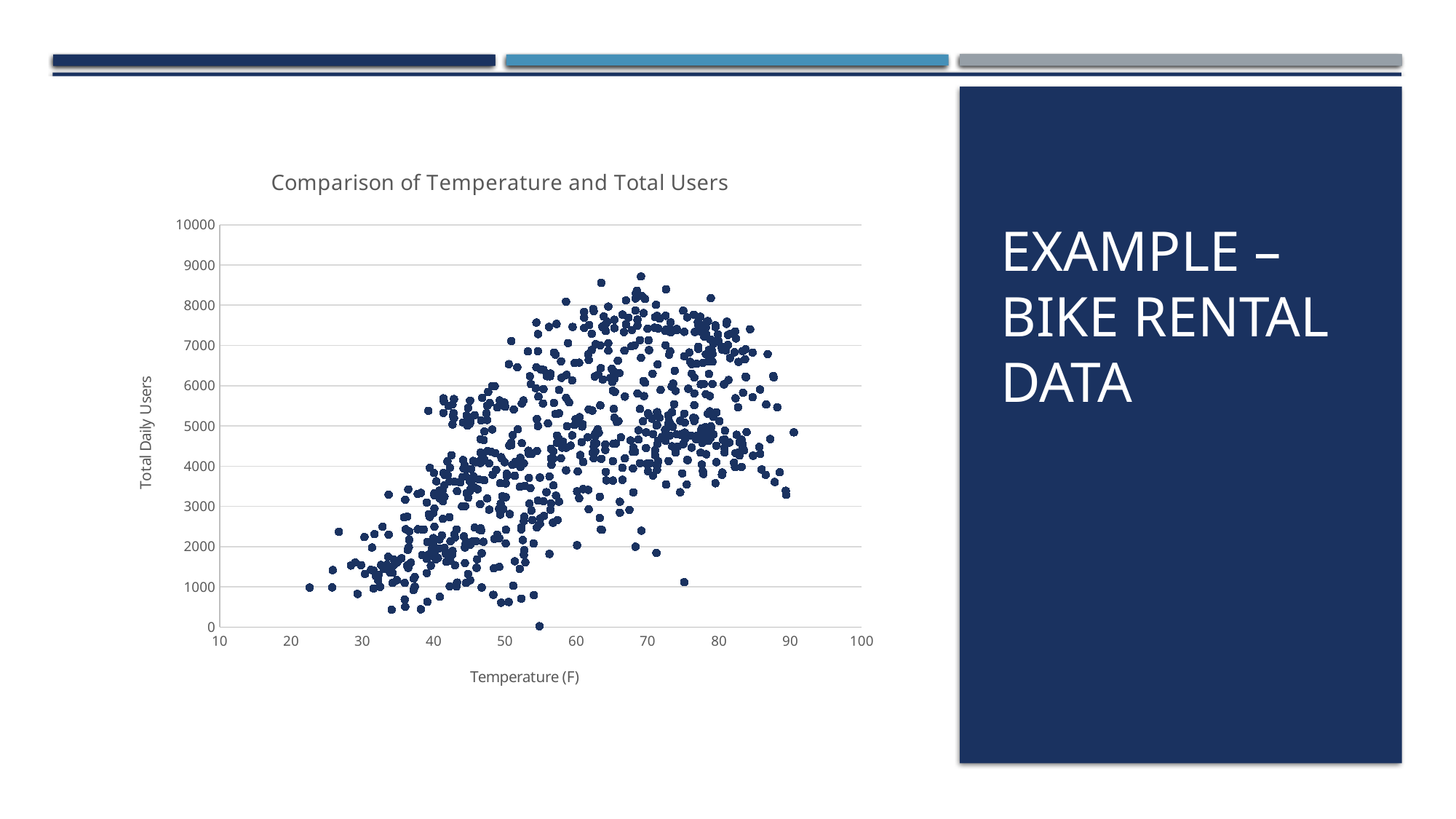
Is the lowest Temperature (F) value plotted greater or less than 20? greater Do the Total Daily Users values generally rise or fall as Temperature (F) increases along the x axis? Rise What is the title of the chart? Comparison of Temperature and Total Users Is the highest Total Daily Users value plotted greater or less than 9000? less Is the lowest Total Daily Users value plotted greater or less than 1000? less What kind of chart is shown on the slide? Scatter plot What are the labels of the x axis and y axis of the chart? Temperature (F) and Total Daily Users